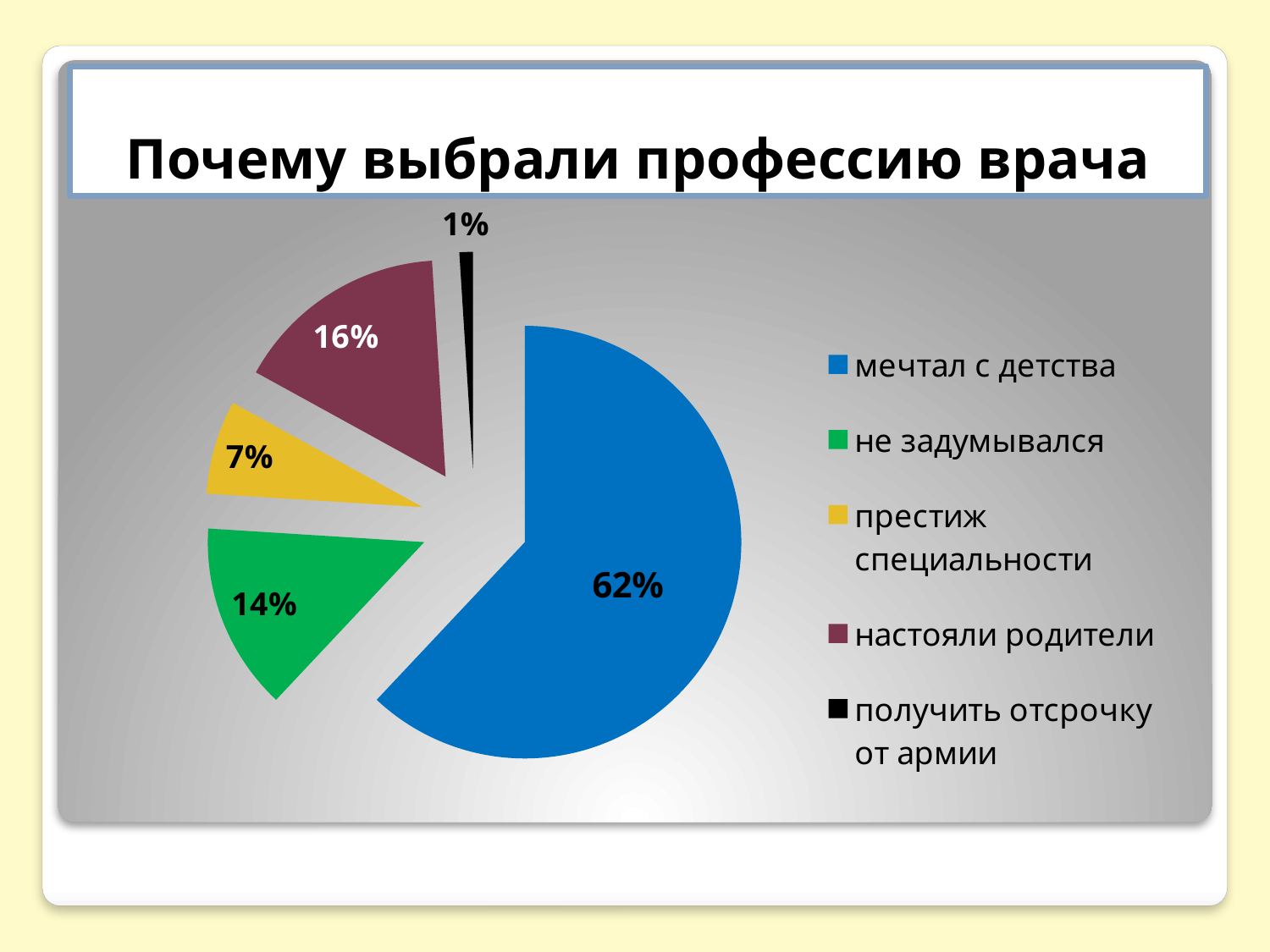
What is the difference between the shares for 'настояли родители' and 'не задумывался'? 2% What kind of chart is shown on the slide? pie chart What share of the pie is labelled 'настояли родители'? 16% What share of the pie is labelled 'престиж специальности'? 7% How many categories does the pie chart have? 5 What share of the pie is labelled 'не задумывался'? 14% Which category has the smallest slice of the pie? получить отсрочку от армии Which is larger: the share for 'не задумывался' or the share for 'престиж специальности'? не задумывался What is the title of the chart? Почему выбрали профессию врача Which category has the largest slice of the pie? мечтал с детства